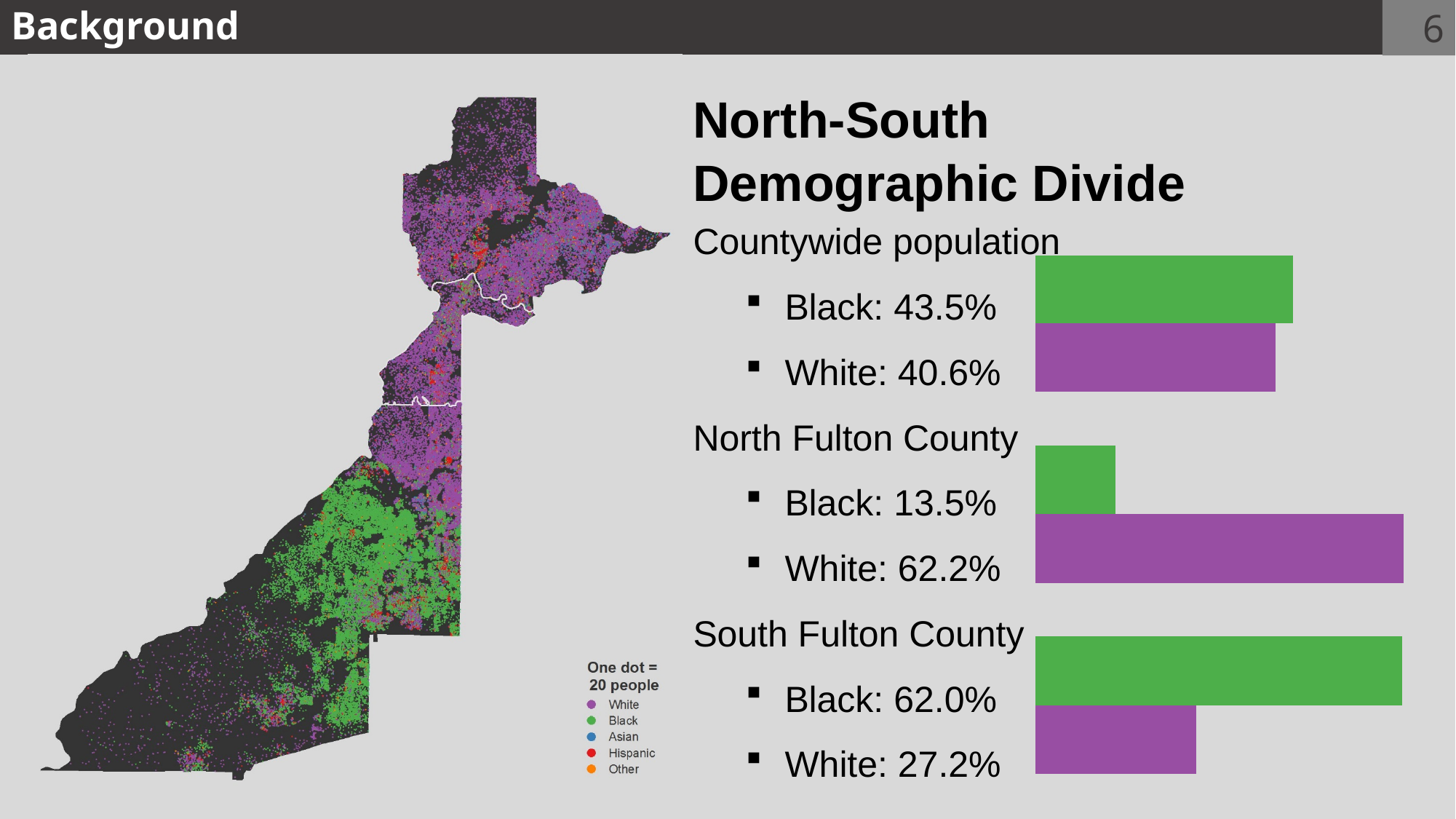
In the Countywide population bar chart, what is the value for Black? 43.5% In the Countywide population bar chart, what is the value for White? 40.6% In the North Fulton County bar chart, which group has the lowest value? Black In the South Fulton County bar chart, what is the value for White? 27.2% In the South Fulton County bar chart, which group has the higher value, Black or White? Black On the map, how many people does one dot represent according to the legend? 20 people In the North Fulton County bar chart, what is the value for Black? 13.5% In the South Fulton County bar chart, what is the difference between the Black and White values? 34.8% In the North Fulton County bar chart, what is the difference between the White and Black values? 48.7% In the Countywide population bar chart, what is the difference between the Black and White values? 2.9% In the North Fulton County bar chart, what is the value for White? 62.2% What kind of chart is used to show the Black and White percentages on the right side of the slide? Bar chart